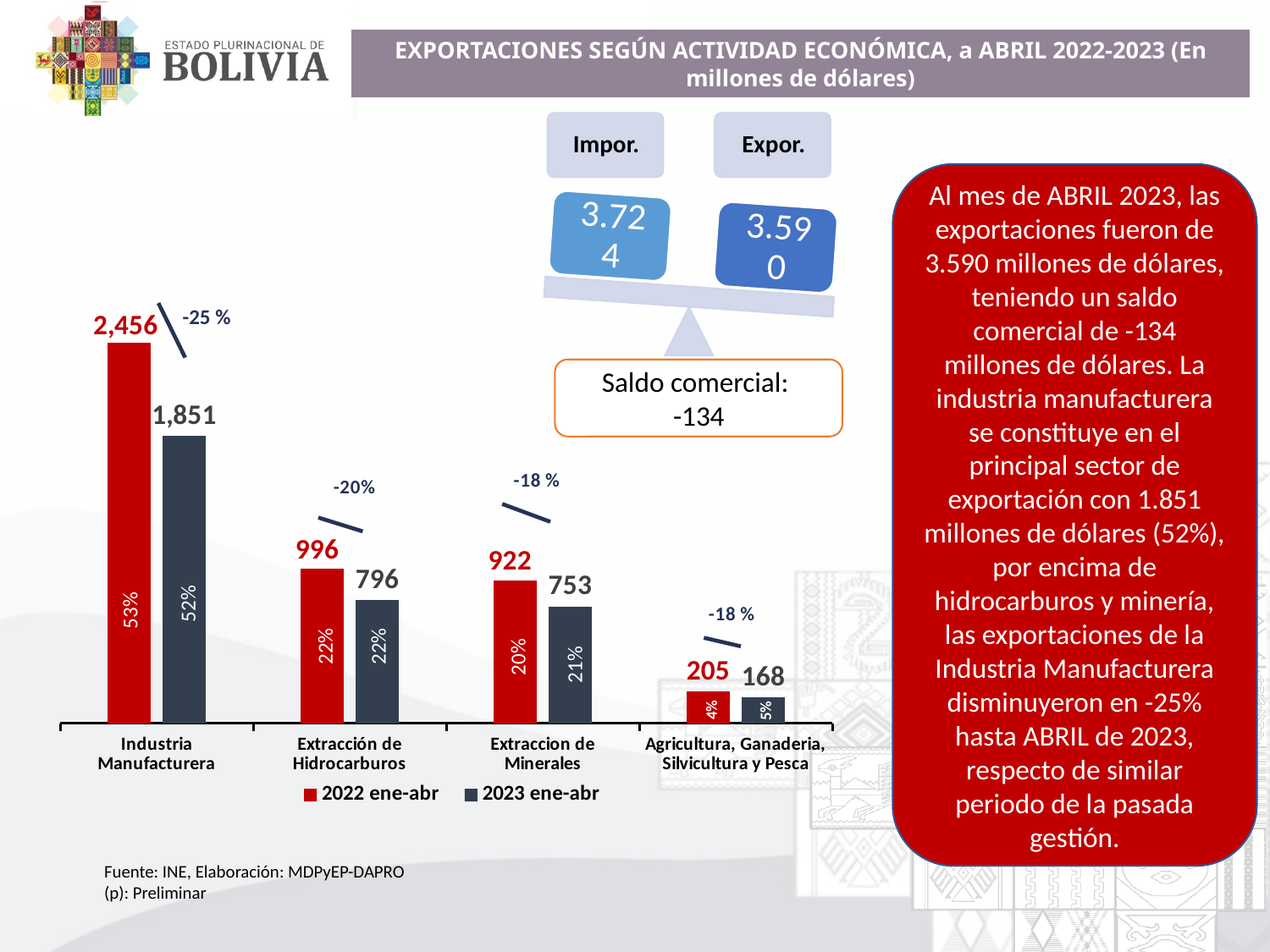
Which category has the lowest value in the 2022 ene-abr series? Agricultura, Ganaderia, Silvicultura y Pesca What is the value for Agricultura, Ganaderia, Silvicultura y Pesca in the 2022 ene-abr series? 205 How many categories are shown on the x axis of the bar chart? 4 What is the value for Extracción de Hidrocarburos in the 2023 ene-abr series? 796 What is the difference between the 2022 ene-abr and 2023 ene-abr values for Extraccion de Minerales? 169 What is the value for Industria Manufacturera in the 2022 ene-abr series? 2,456 Which category has the highest value in the 2023 ene-abr series? Industria Manufacturera What kind of chart is used to show exports by economic activity? Bar chart What is the value for Industria Manufacturera in the 2023 ene-abr series? 1,851 What percentage change is shown above the Industria Manufacturera bars? -25 % Which is larger: the 2022 ene-abr value for Extracción de Hidrocarburos or the 2022 ene-abr value for Extraccion de Minerales? Extracción de Hidrocarburos How many series does the legend list? 2